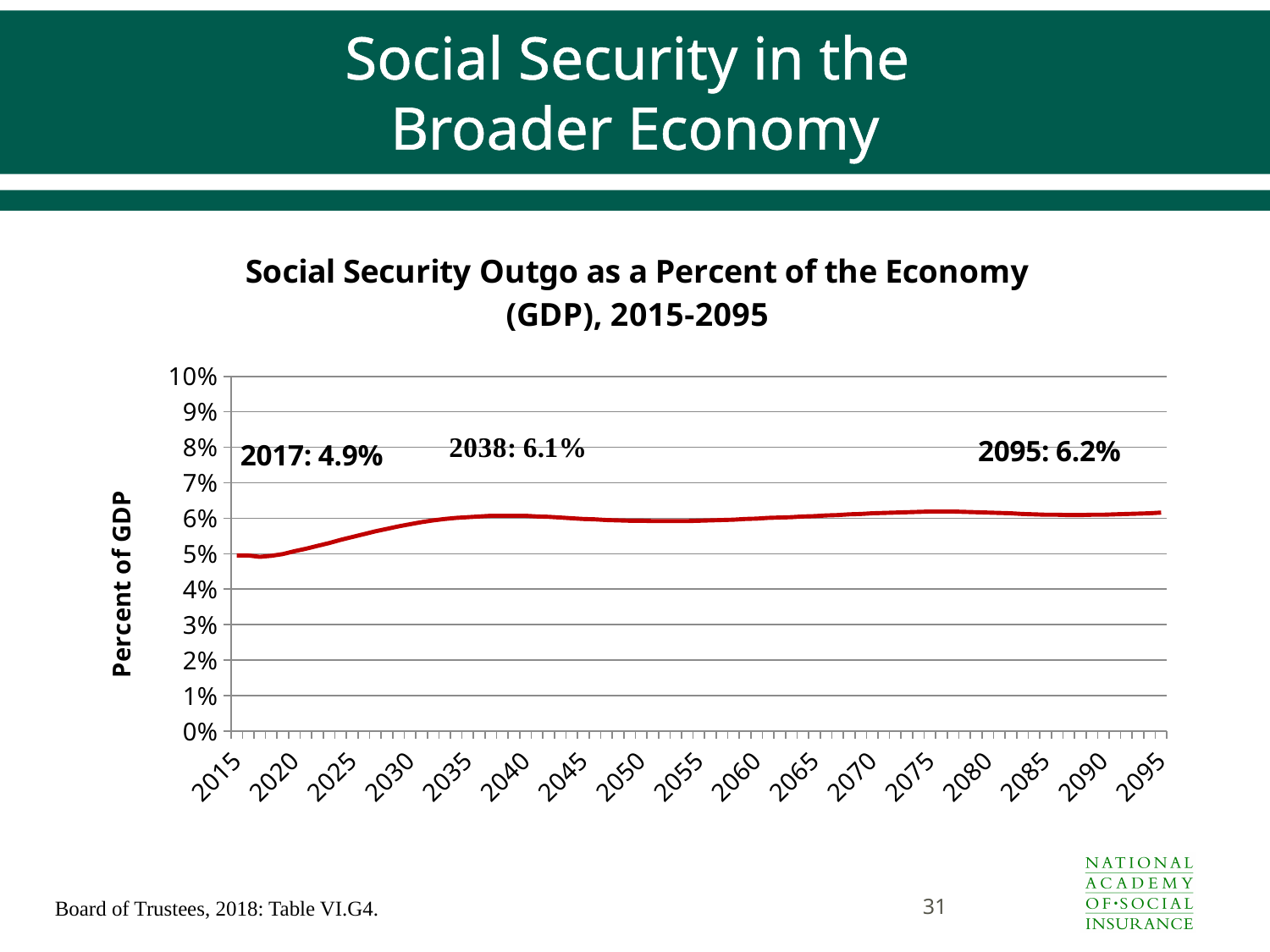
What kind of chart is shown on the slide? line chart What value is labeled for 2017 on the chart? 4.9% Which labeled year has the higher value, 2017 or 2038? 2038 Is the value for 2050 greater or less than 5%? greater By how many percentage points does the labeled 2095 value exceed the labeled 2017 value? 1.3 percentage points Of the three labeled years (2017, 2038, 2095), which has the lowest value? 2017 What is the label on the vertical axis of the chart? Percent of GDP Does the line rise or fall between 2020 and 2035? rise What value is labeled for 2038 on the chart? 6.1% Is the value for 2015 greater or less than 6%? less What value is labeled for 2095 on the chart? 6.2% By how many percentage points does the labeled 2038 value exceed the labeled 2017 value? 1.2 percentage points